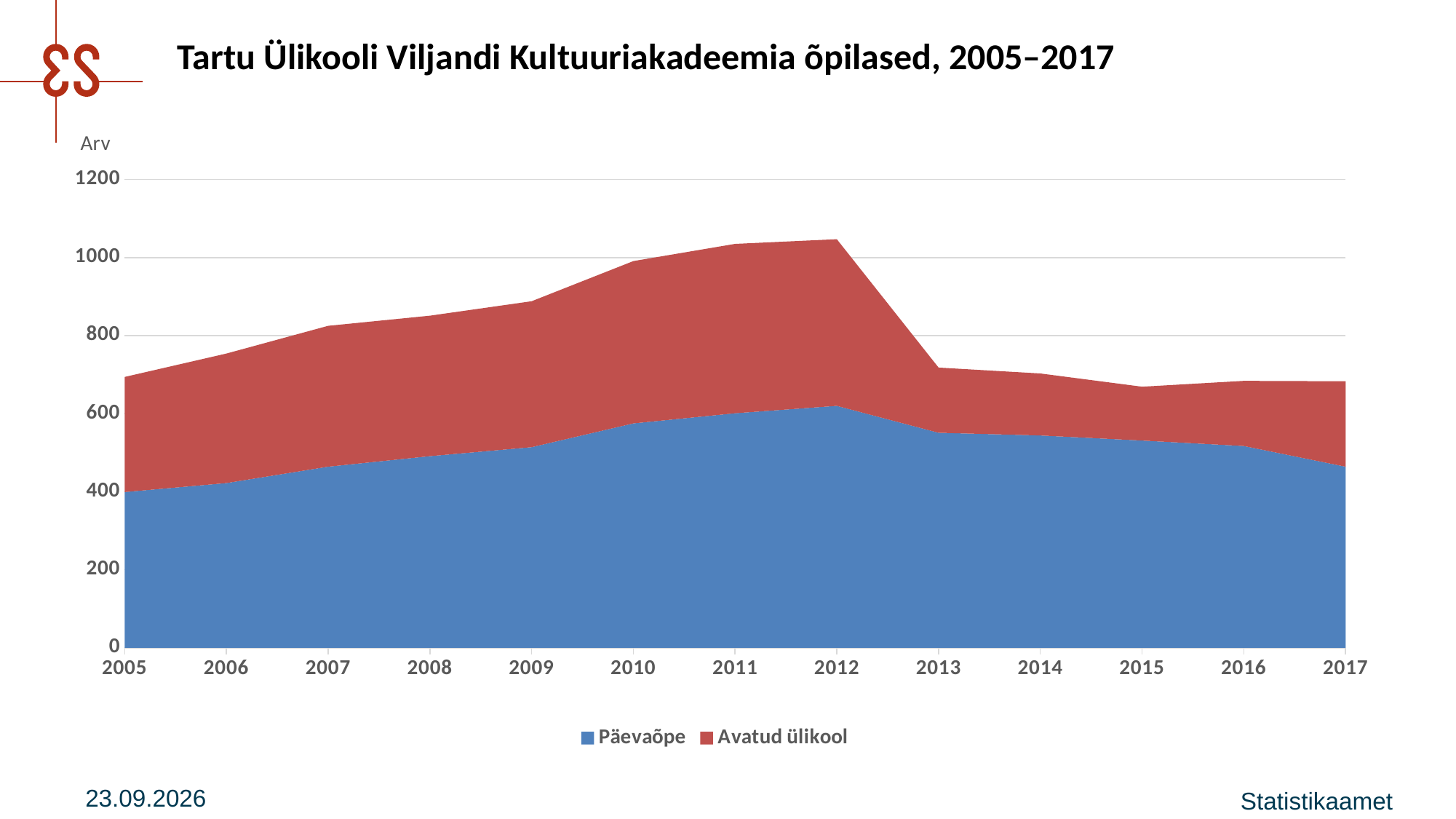
In which year is the combined total of Päevaõpe and Avatud ülikool highest? 2012 Which series is shown in blue? Päevaõpe What kind of chart is shown on the slide? Stacked area chart Is the value for Päevaõpe in 2017 greater or less than 400? greater How many series does the legend list? 2 What is the title of the chart? Tartu Ülikooli Viljandi Kultuuriakadeemia õpilased, 2005–2017 How many years are shown along the x axis? 13 Does the combined total rise or fall from 2005 to 2012? rise Is the value for Päevaõpe in 2012 greater or less than 600? greater Is the combined total for 2012 greater or less than 1000? greater Does the value for Päevaõpe rise or fall from 2012 to 2017? fall